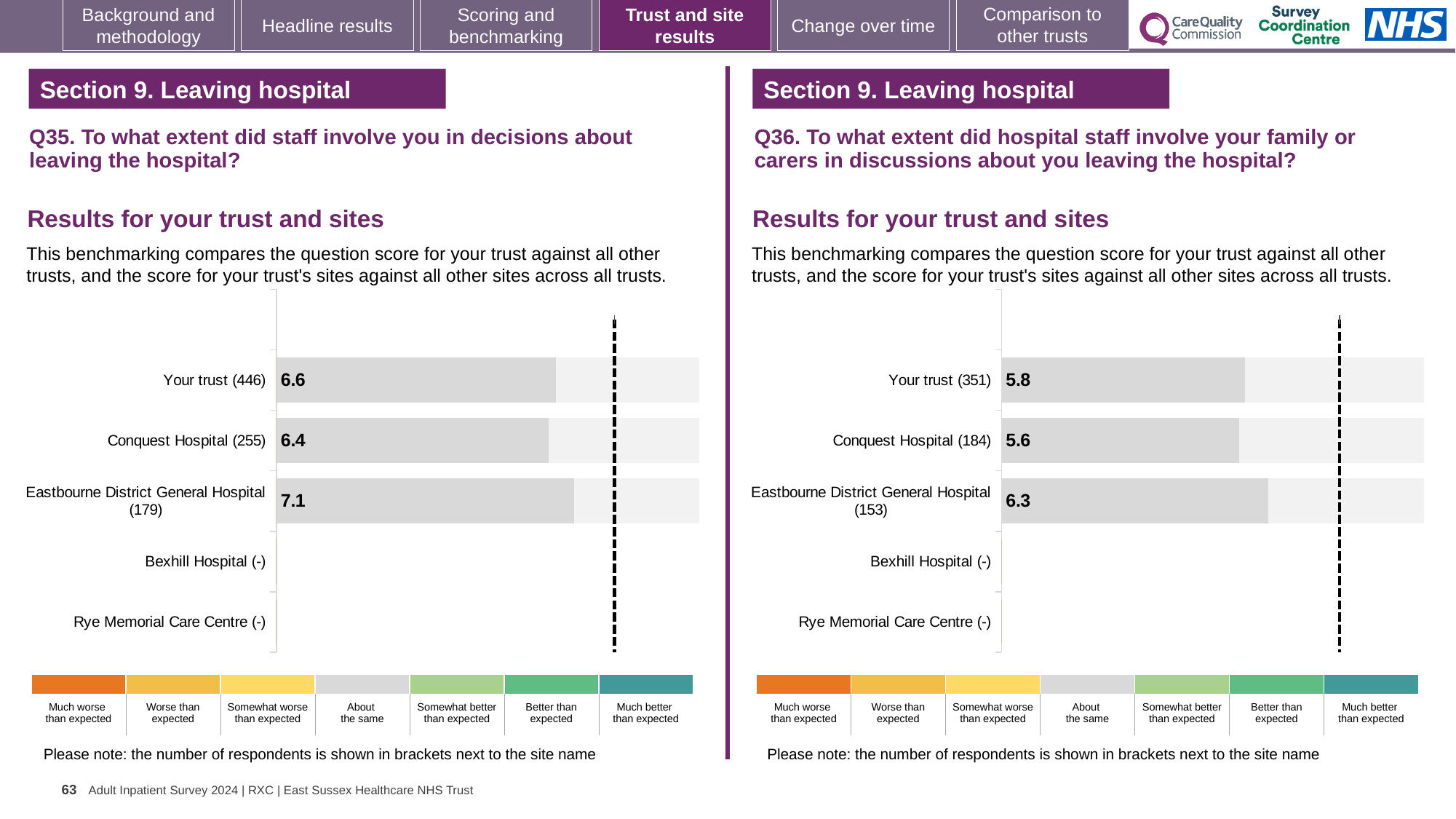
On the Q36 chart (right), how many sites or trusts are listed on the vertical axis? 5 On the Q35 chart (left), which site or trust has the highest score? Eastbourne District General Hospital On the Q35 chart (left), how many respondents are shown for Your trust? 446 On the Q35 chart (left), what is the difference between the scores for Eastbourne District General Hospital and Conquest Hospital? 0.7 On the Q36 chart (right), what is the score for Eastbourne District General Hospital? 6.3 On the Q36 chart (right), which is larger: the score for Your trust or the score for Conquest Hospital? Your trust On the Q36 chart (right), what is the score for Your trust? 5.8 On the Q36 chart (right), which of the labelled bars has the lowest score? Conquest Hospital On the Q35 chart (left), what is the score for Your trust? 6.6 What kind of chart is used on the Q35 chart (left)? Bar chart On the Q35 chart (left), what is the score for Conquest Hospital? 6.4 On the Q36 chart (right), what is the difference between the scores for Your trust and Conquest Hospital? 0.2